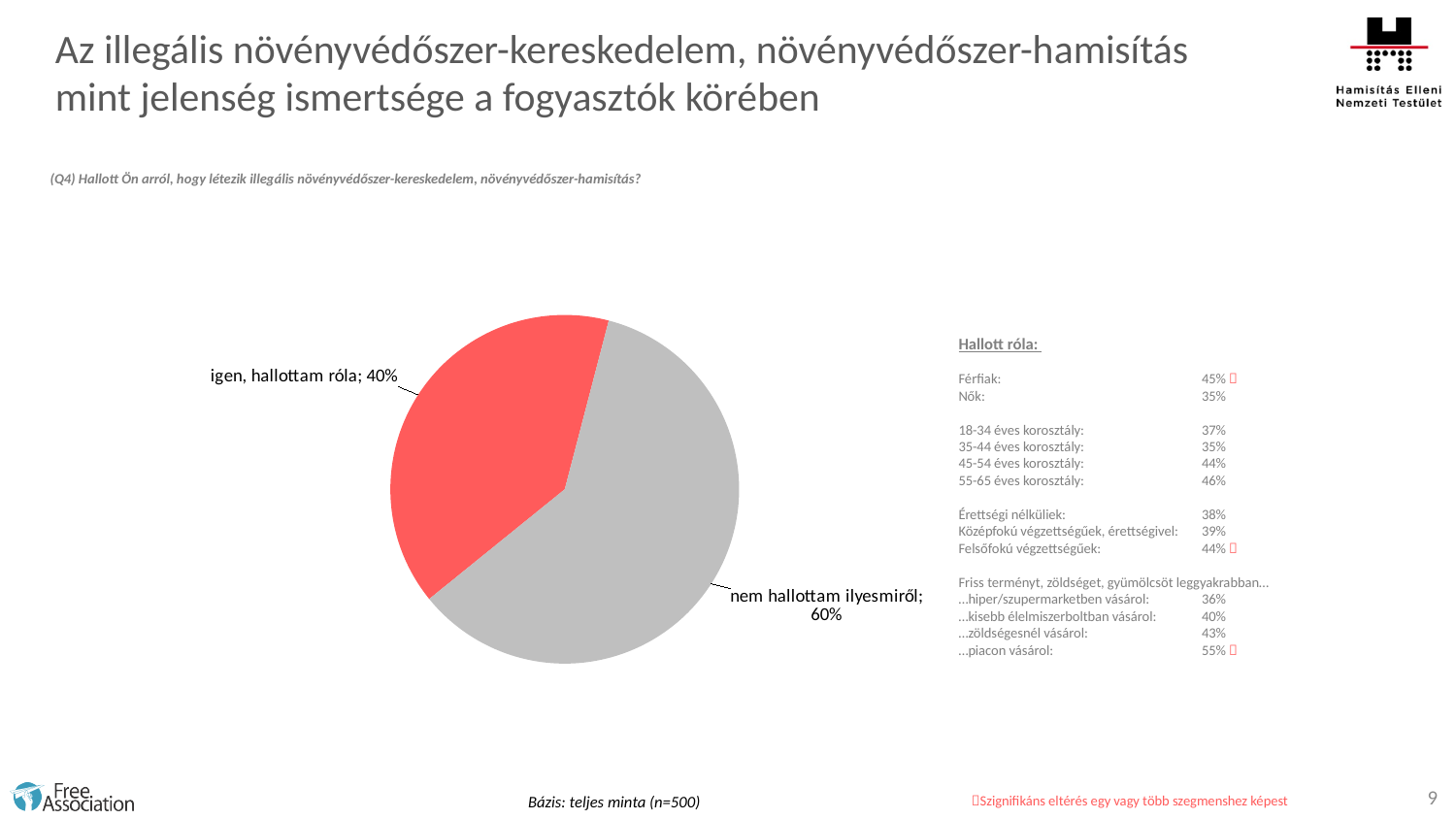
Which is larger: the "igen, hallottam róla" slice or the "nem hallottam ilyesmiről" slice? nem hallottam ilyesmiről What kind of chart is shown on the slide? pie chart Which slice of the pie chart is the smallest? igen, hallottam róla What colour is the "nem hallottam ilyesmiről" slice of the pie chart? grey How many slices does the pie chart have? 2 What colour is the "igen, hallottam róla" slice of the pie chart? red What is the total of the two slices shown in the pie chart? 100% Which slice of the pie chart is the largest? nem hallottam ilyesmiről Is the share for "igen, hallottam róla" greater or less than 50%? less What share of the pie is labelled "nem hallottam ilyesmiről"? 60% What is the difference in percentage points between the "nem hallottam ilyesmiről" slice and the "igen, hallottam róla" slice? 20 percentage points What share of the pie is labelled "igen, hallottam róla"? 40%